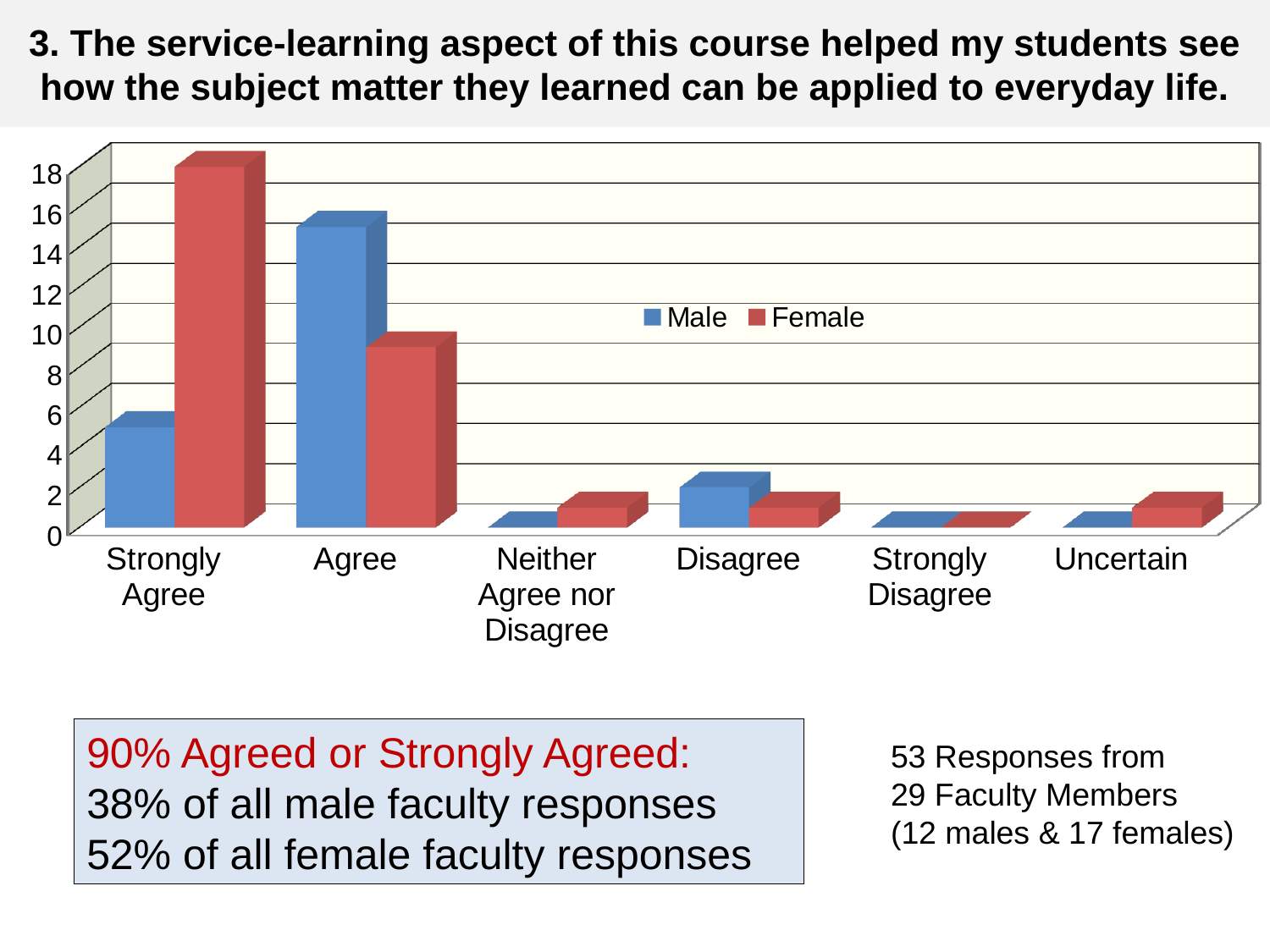
Is the Male value for Agree greater or less than 12? greater How many series does the legend list? 2 Is the Male value for Strongly Agree greater or less than 8? less Which category has the highest value for the Female series? Strongly Agree Is the Female value for Strongly Agree greater or less than 16? greater For the Strongly Agree category, which series has the larger value, Male or Female? Female Which category has the highest value for the Male series? Agree For the Agree category, which series has the larger value, Male or Female? Male What kind of chart is shown on the slide? bar chart How many response categories are shown on the x axis? 6 What colour are the Female bars in the chart? red